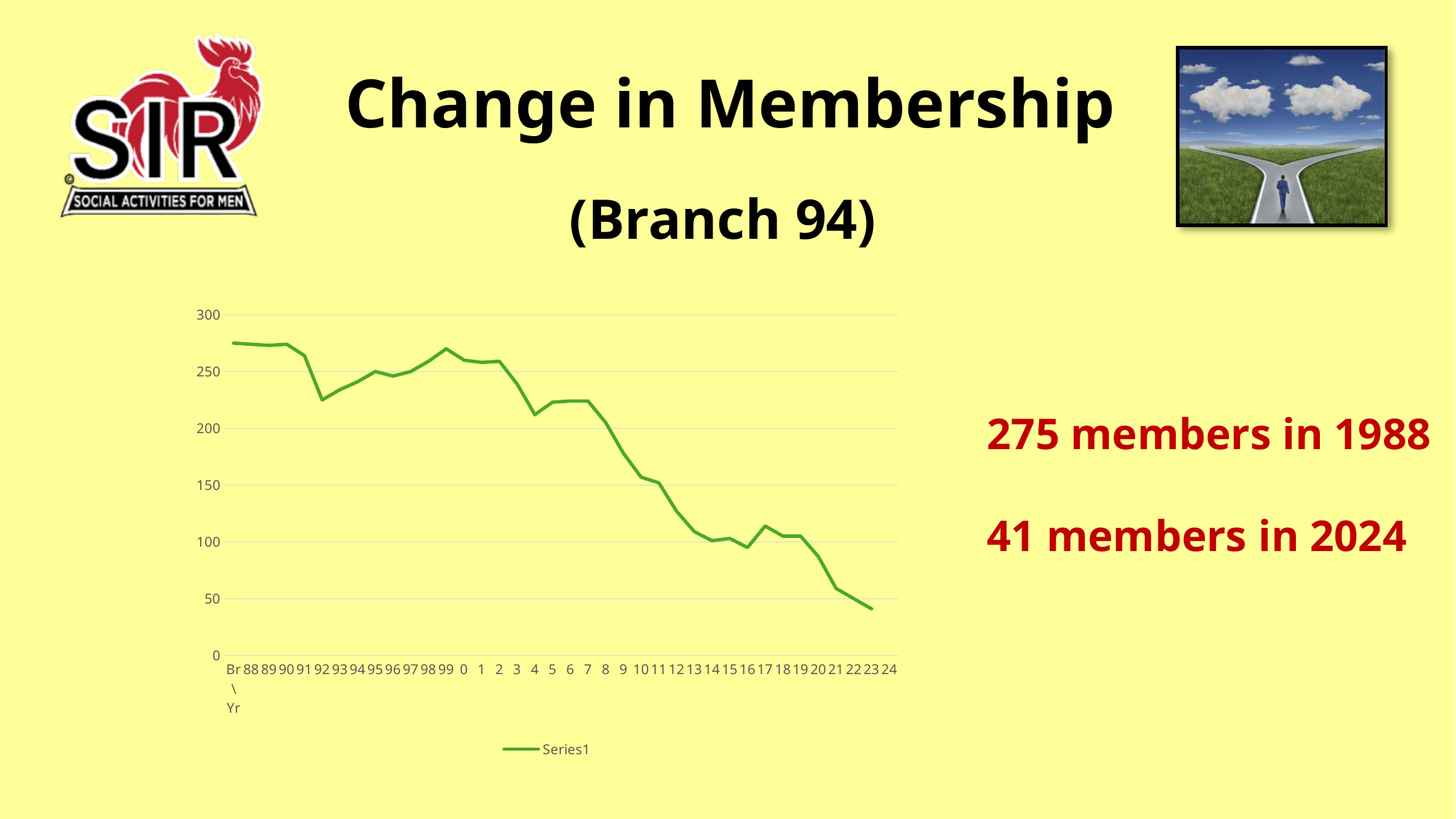
Overall, do the membership values rise or fall from left to right along the x axis? fall Is the value at the x-axis label 88 greater or less than 250? greater How many series does the chart legend list? 1 What kind of chart is shown on the slide? line chart According to the slide, how many members did Branch 94 have in 1988? 275 Which is larger, the membership in 1988 or the membership in 2024? 1988 Is the lowest point of the line at the left end or the right end of the x axis? right end Is the value at the x-axis label 22 greater or less than 100? less What is the title of the slide containing the chart? Change in Membership (Branch 94) According to the slide, how many members did Branch 94 have in 2024? 41 What is the name of the series shown in the chart legend? Series1 By how much did membership decrease between 1988 (275 members) and 2024 (41 members)? 234